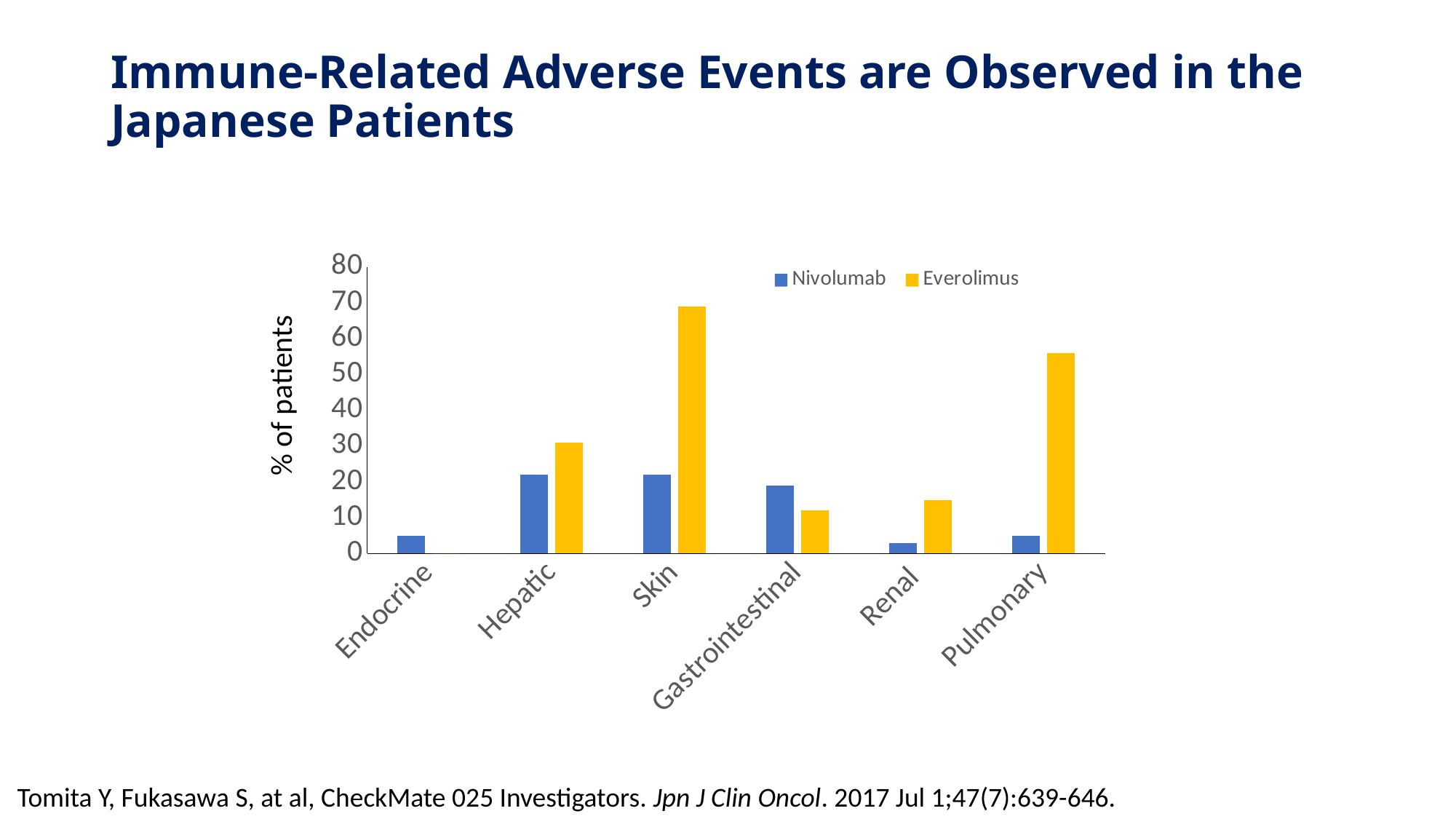
Is the Everolimus value for Skin greater or less than 60? greater What kind of chart is shown on the slide? bar chart Which category has the lowest Nivolumab value? Renal For Gastrointestinal, which series has the larger value, Nivolumab or Everolimus? Nivolumab Which category shows no visible Everolimus bar? Endocrine Is the Nivolumab value for Gastrointestinal greater or less than 20? less For Pulmonary, which series has the larger value, Nivolumab or Everolimus? Everolimus Which category has the highest Everolimus value? Skin How many adverse event categories are shown on the x axis? 6 What is the label of the y axis? % of patients How many series does the legend list? 2 Is the Everolimus value for Pulmonary greater or less than 50? greater